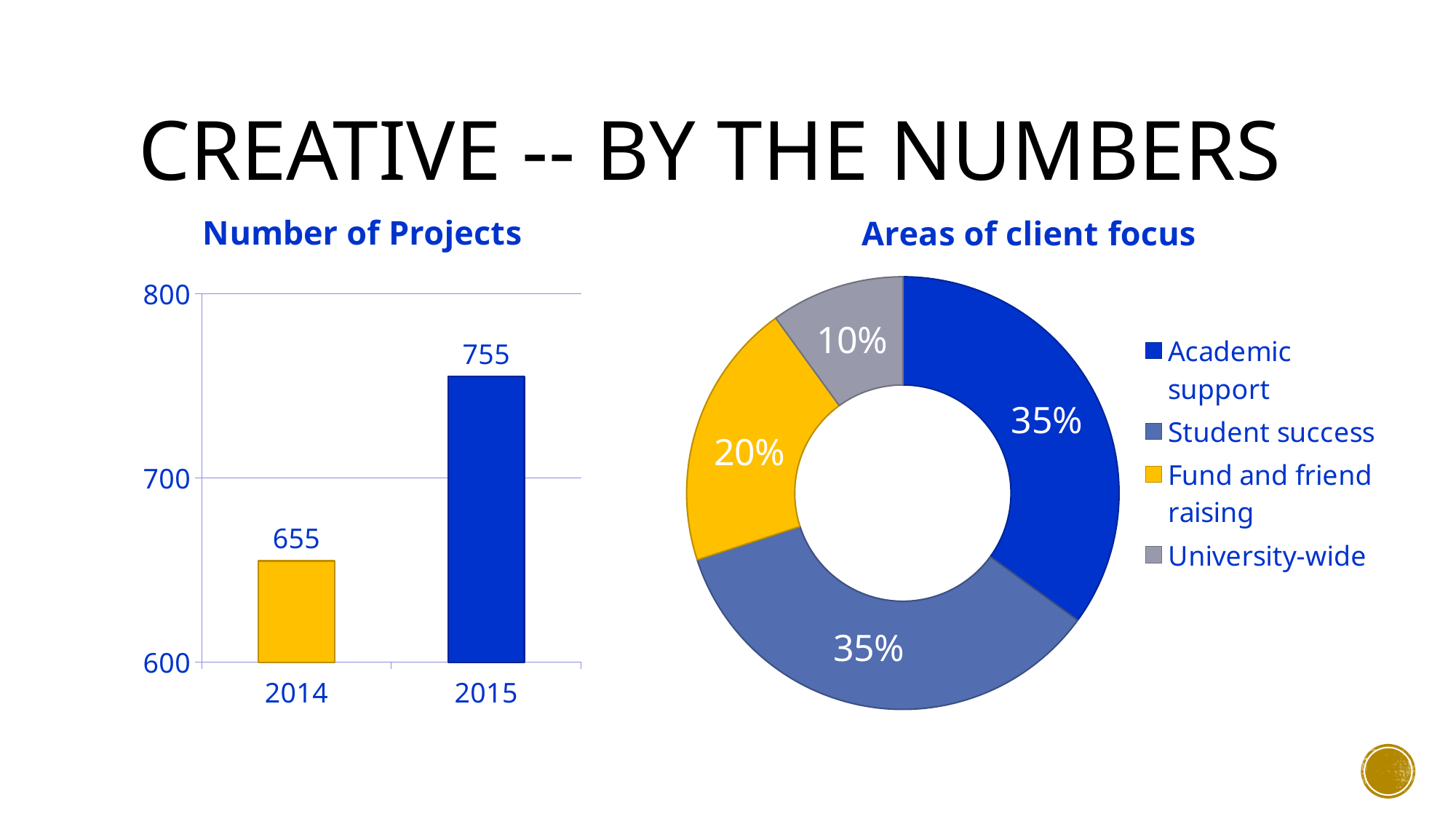
In the 'Number of Projects' chart, what is the value for 2014? 655 In the 'Number of Projects' chart, which year has the higher value? 2015 What kind of chart is the 'Number of Projects' chart? bar chart In the 'Number of Projects' chart, is the value for 2014 greater or less than 700? less How many categories does the legend of the 'Areas of client focus' chart list? 4 In the 'Number of Projects' chart, what is the difference between the 2015 and 2014 values? 100 In the 'Areas of client focus' chart, what colour is the Academic support slice? blue In the 'Number of Projects' chart, what is the value for 2015? 755 In the 'Number of Projects' chart, do the values rise or fall from 2014 to 2015? rise In the 'Areas of client focus' chart, what share does Fund and friend raising have? 20% In the 'Areas of client focus' chart, which category has the smallest share? University-wide In the 'Areas of client focus' chart, what share does University-wide have? 10%